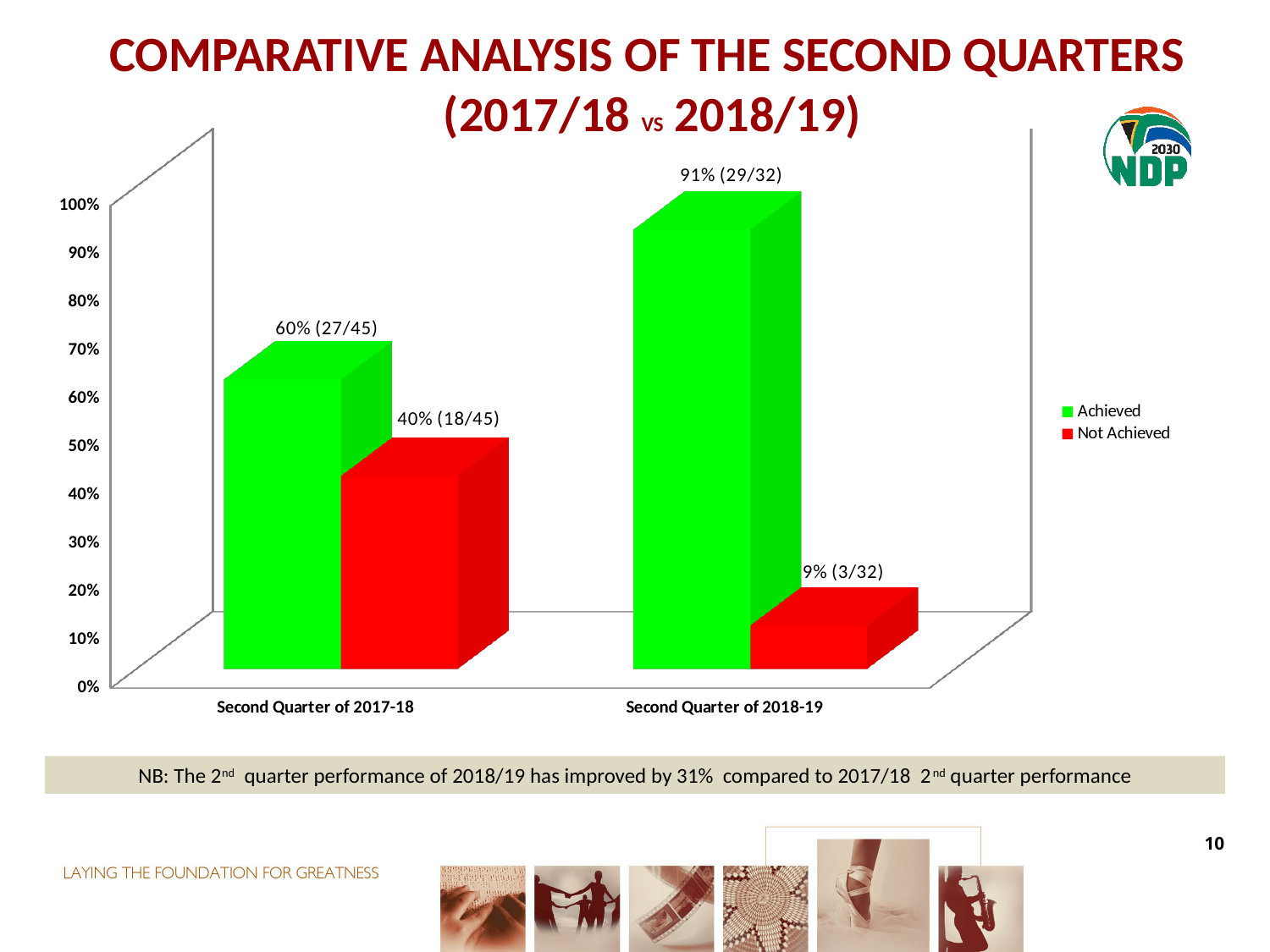
Which colour represents the Not Achieved series in the legend? red Is the Not Achieved value for Second Quarter of 2017-18 larger or smaller than the Not Achieved value for Second Quarter of 2018-19? larger What kind of chart is shown on the slide? bar chart What is the Not Achieved value for Second Quarter of 2018-19? 9% (3/32) What is the Achieved value for Second Quarter of 2017-18? 60% (27/45) What is the Not Achieved value for Second Quarter of 2017-18? 40% (18/45) Which quarter has the lower Not Achieved percentage? Second Quarter of 2018-19 How many categories are shown on the x axis? 2 How many series does the legend list? 2 What is the Achieved value for Second Quarter of 2018-19? 91% (29/32) Which quarter has the higher Achieved percentage? Second Quarter of 2018-19 What is the difference in Achieved percentage between Second Quarter of 2018-19 and Second Quarter of 2017-18? 31%